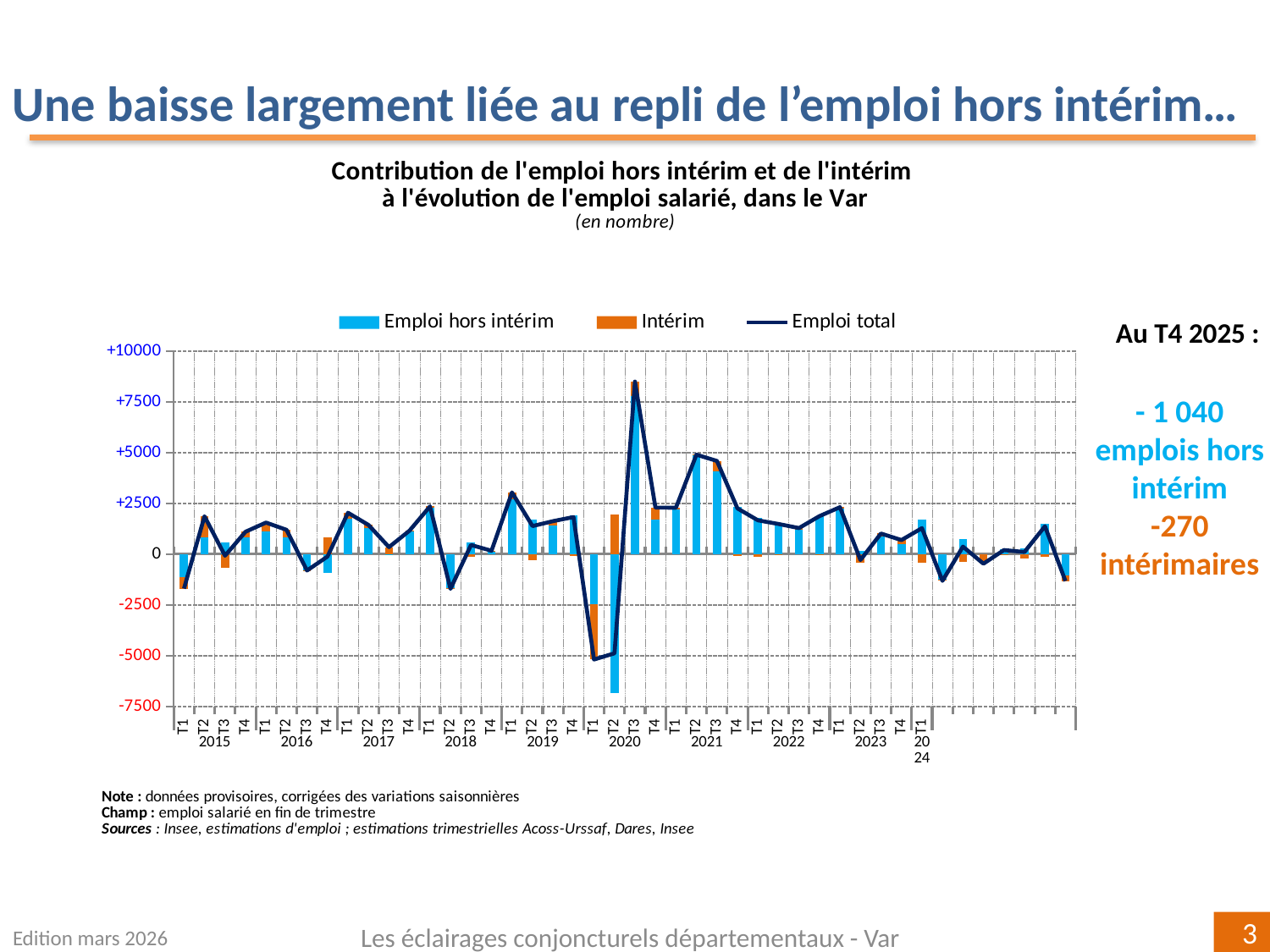
According to the slide, what is the contribution of emploi hors intérim in T4 2025? - 1 040 Is the value of Emploi total in T3 2020 greater or less than +7500? greater How many series does the chart legend list? 3 What kind of chart is shown on the slide? A bar chart combined with a line chart Does the Emploi total line rise or fall between T3 2020 and T4 2020? It falls According to the slide, what is the contribution of intérimaires in T4 2025? -270 Which colour represents the Intérim series in the chart? Orange Is the value of Emploi hors intérim in T2 2020 greater or less than -5000? less In which quarter is the Emploi hors intérim bar at its lowest? T2 2020 Which is larger, the Emploi total value in T3 2020 or in T2 2021? T3 2020 Is the value of Emploi total in T2 2021 greater or less than +2500? greater In which quarter does the Emploi total line reach its highest value? T3 2020